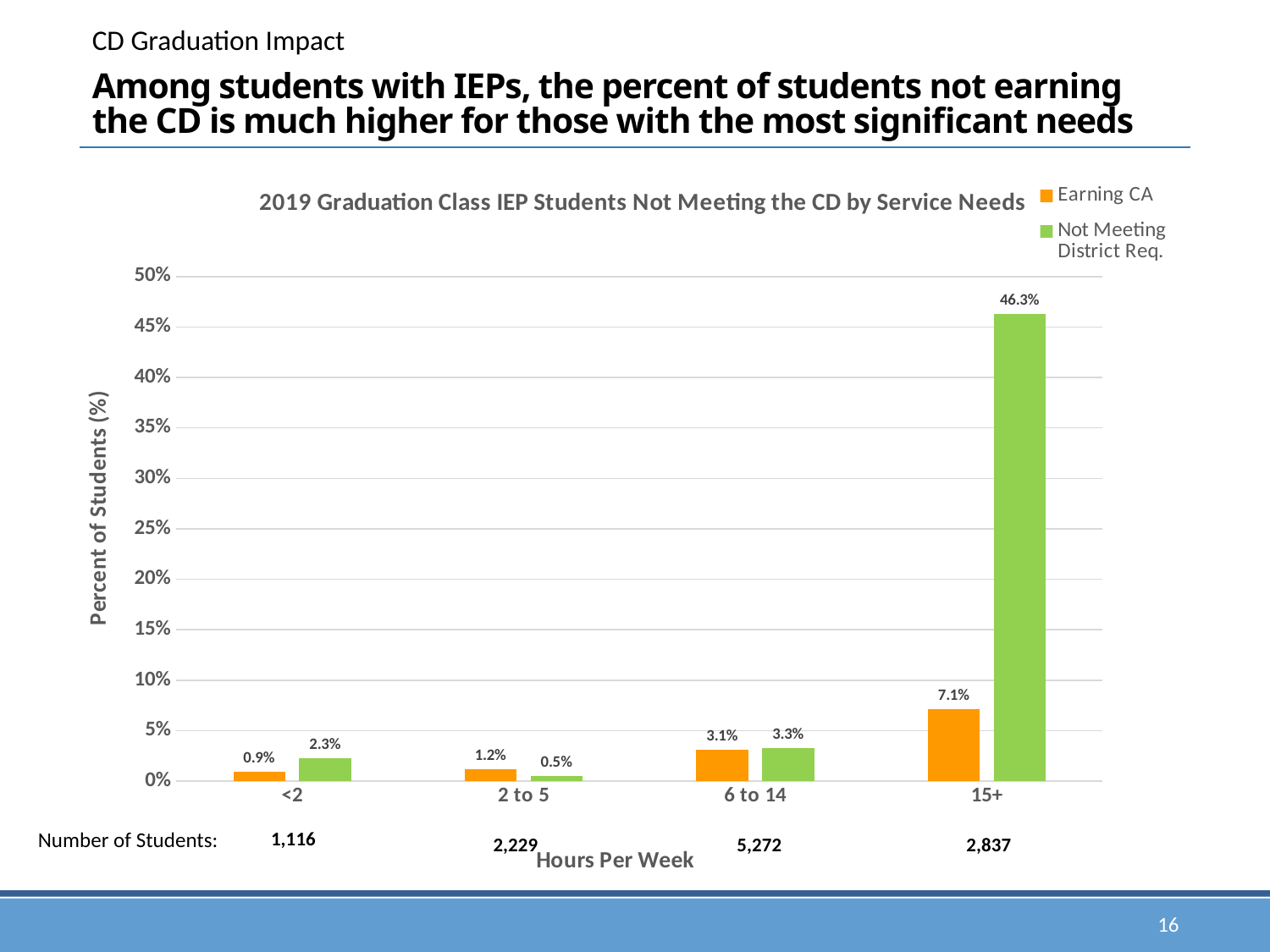
How many series does the legend list? 2 What is the difference between the Not Meeting District Req. and Earning CA values in the 15+ category? 39.2% What kind of chart is shown on the slide? Bar chart What is the value for Earning CA in the 6 to 14 hours per week category? 3.1% Which hours-per-week category has the lowest value for Earning CA? <2 Which hours-per-week category has the highest value for Not Meeting District Req.? 15+ What is the title of the chart? 2019 Graduation Class IEP Students Not Meeting the CD by Service Needs In the 2 to 5 hours per week category, which is larger: Earning CA or Not Meeting District Req.? Earning CA Is the value for Not Meeting District Req. in the 15+ category greater or less than 45%? greater What is the value for Not Meeting District Req. in the 2 to 5 hours per week category? 0.5% How many hours-per-week categories are shown on the x axis? 4 What is the value for Not Meeting District Req. in the 15+ hours per week category? 46.3%